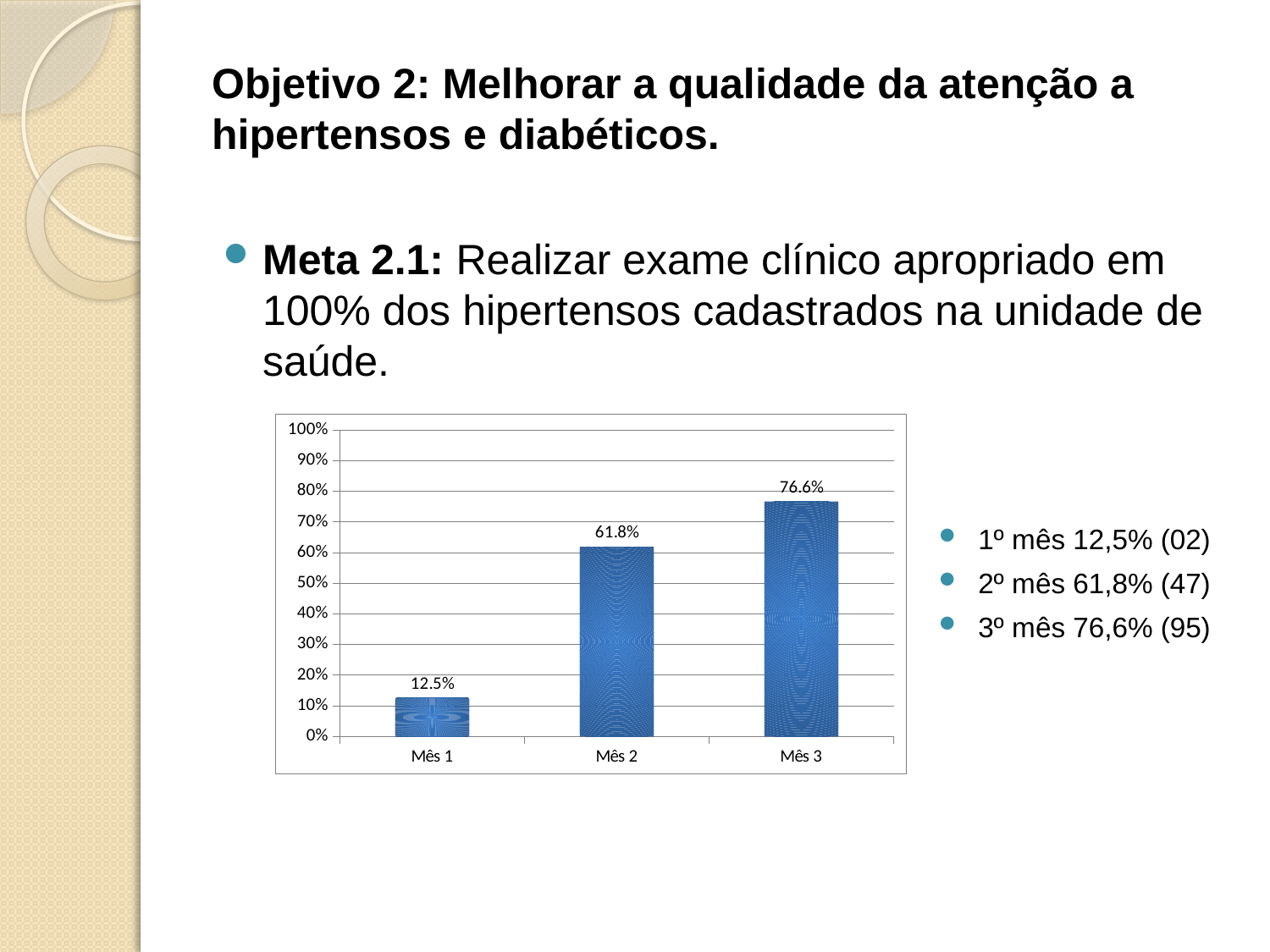
Do the values rise or fall from Mês 1 to Mês 3? rise What kind of chart is shown on the slide? bar chart Which month has the lowest value? Mês 1 What is the value for Mês 3? 76.6% Which month has the highest value? Mês 3 Is the value for Mês 3 greater or less than 70%? greater Which is larger, the value for Mês 1 or the value for Mês 2? Mês 2 How many categories are shown on the x axis? 3 What is the difference between the values for Mês 2 and Mês 1? 49.3% What is the value for Mês 1? 12.5% What is the value for Mês 2? 61.8% What is the difference between the values for Mês 3 and Mês 2? 14.8%